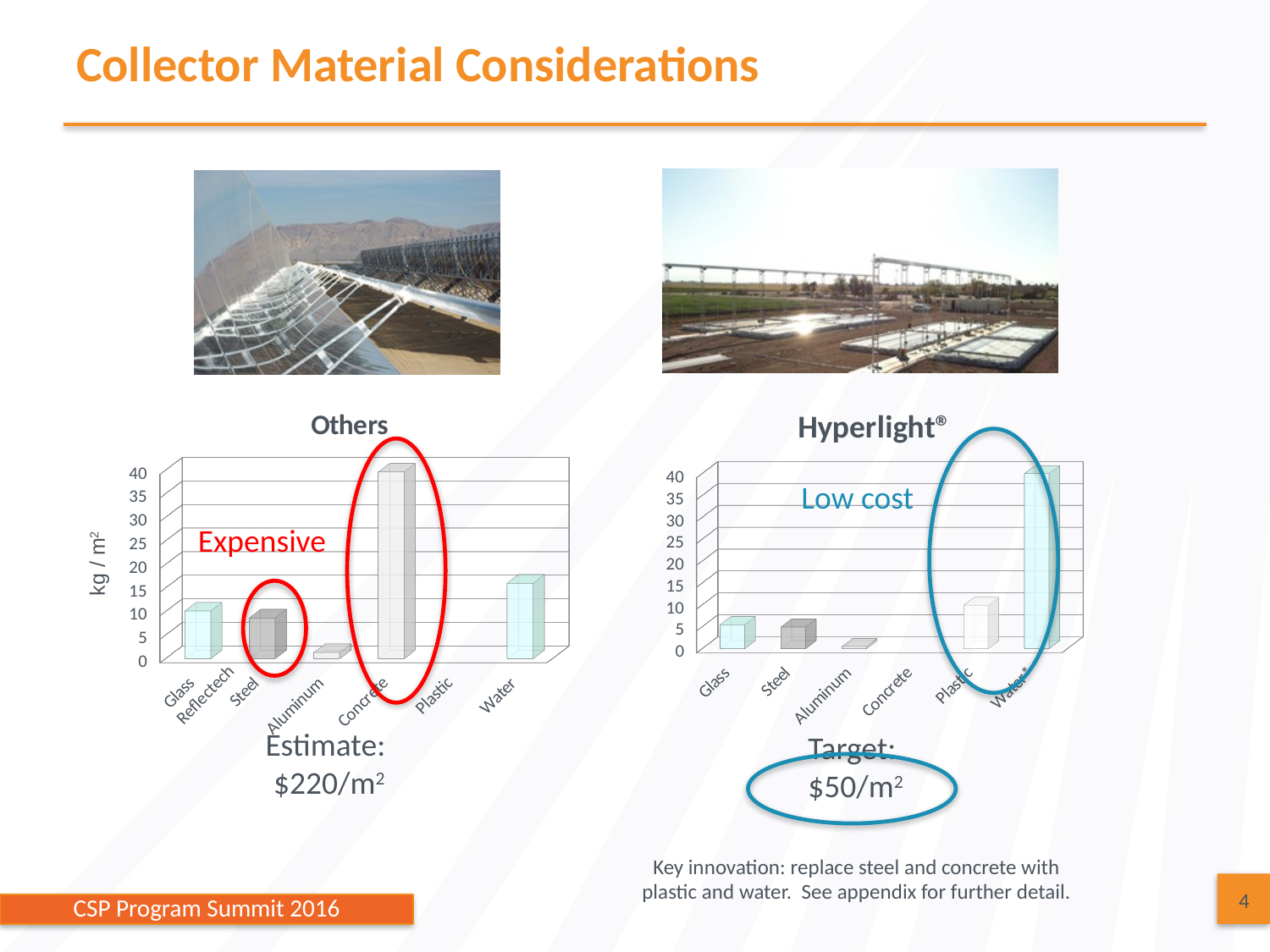
In the "Others" chart, which material has the highest value? Concrete In the "Hyperlight®" chart, which material has the lowest value? Concrete In the "Others" chart, is the value for Water greater or less than 10? greater How many material categories are shown on the x axis of the "Hyperlight®" chart? 6 In the "Hyperlight®" chart, which is larger, the value for Plastic or the value for Glass? Plastic In the "Others" chart, which is larger, the value for Water or the value for Steel? Water What is the y-axis label of the "Others" chart? kg / m² In the "Hyperlight®" chart, which material has the highest value? Water* What kind of chart is the "Others" chart? bar chart In the "Hyperlight®" chart, is the value for Plastic greater or less than 20? less In the "Hyperlight®" chart, is the value for Water* greater or less than 30? greater